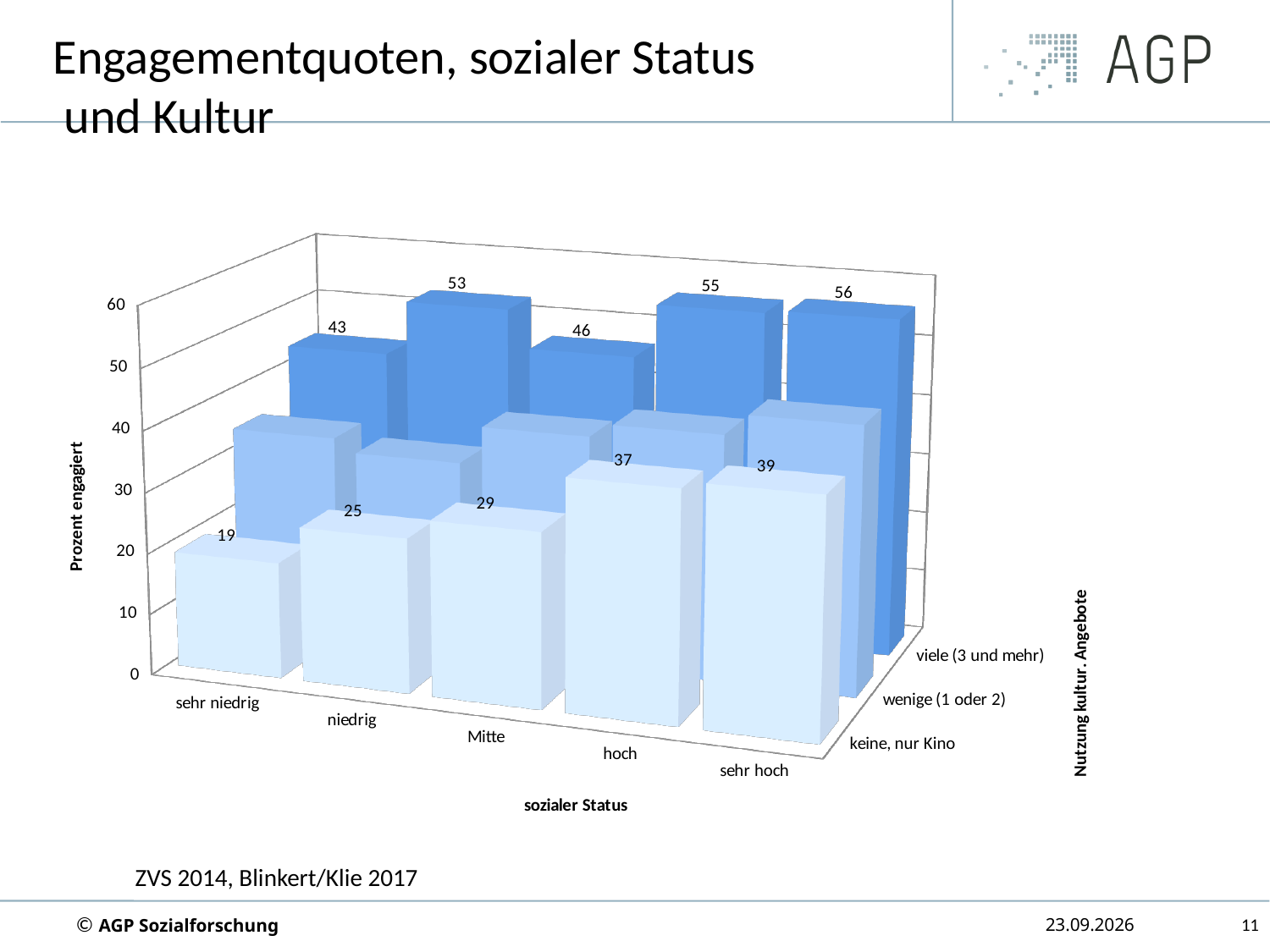
Which social status category has the lowest value in the 'viele (3 und mehr)' series? sehr niedrig What is the value for 'Mitte' in the 'viele (3 und mehr)' series? 46 Do the values in the 'keine, nur Kino' series rise or fall from 'sehr niedrig' to 'sehr hoch'? rise How many series (levels of 'Nutzung kultur. Angebote') does the chart show? 3 Which social status category has the highest value in the 'keine, nur Kino' series? sehr hoch Which is larger in the 'viele (3 und mehr)' series: 'niedrig' or 'Mitte'? niedrig What is the label of the vertical axis? Prozent engagiert What is the value for 'sehr hoch' in the 'viele (3 und mehr)' series? 56 How many social status categories are shown on the x axis? 5 What is the difference between the 'viele (3 und mehr)' and 'keine, nur Kino' values for 'niedrig'? 28 What kind of chart is shown on the slide? bar chart What is the value for 'sehr niedrig' in the 'keine, nur Kino' series? 19